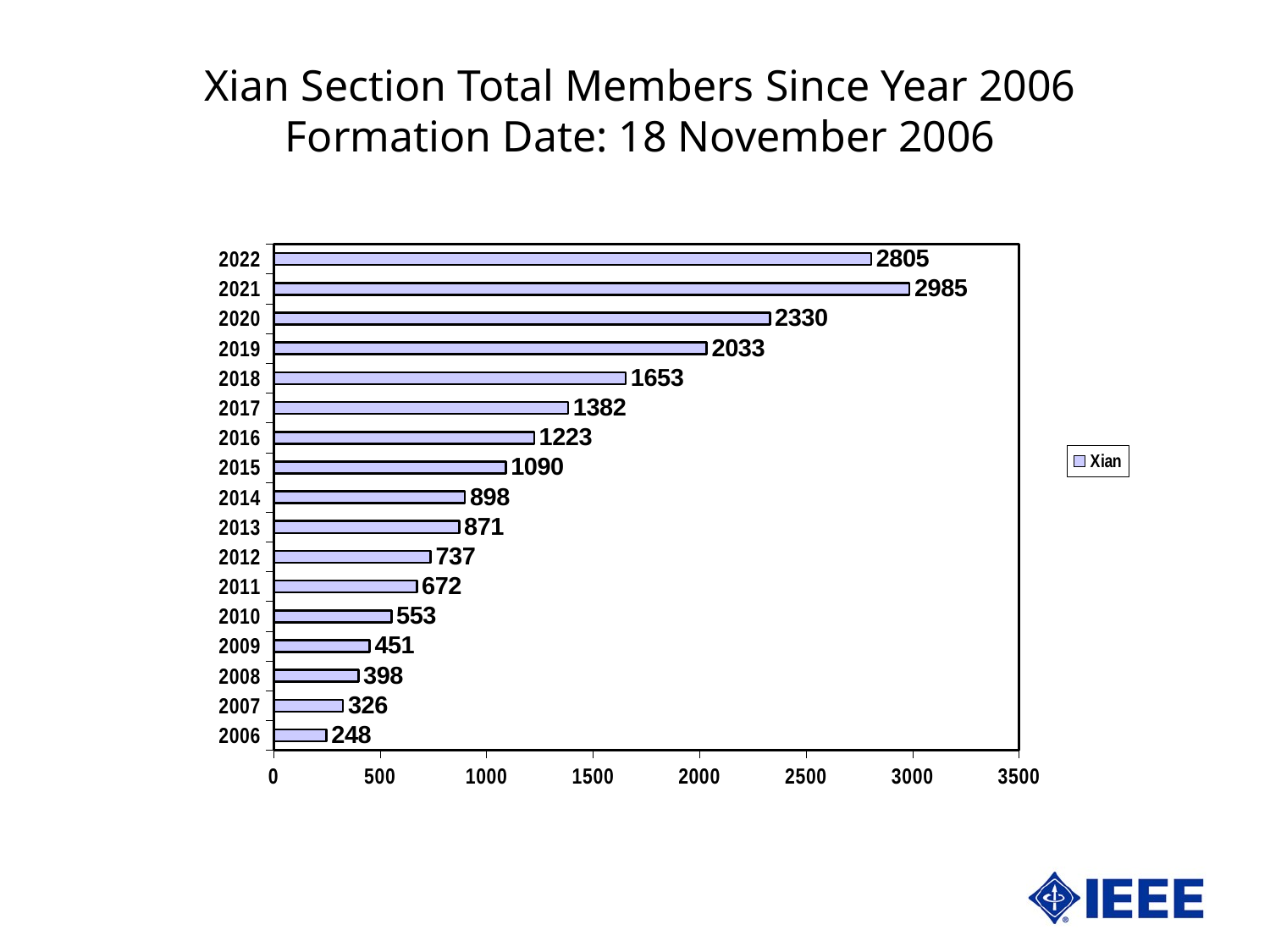
What is the difference between the values for 2020 and 2019? 297 What is the value for 2006? 248 What is the value for 2022? 2805 Which is larger, the value for 2014 or the value for 2013? 2014 Which year has the highest value? 2021 Is the value for 2018 greater or less than 1500? greater What series name does the legend show? Xian Which year has the lowest value? 2006 What is the difference between the values for 2021 and 2022? 180 How many years are shown on the chart? 17 What is the value for 2015? 1090 What kind of chart is this? bar chart